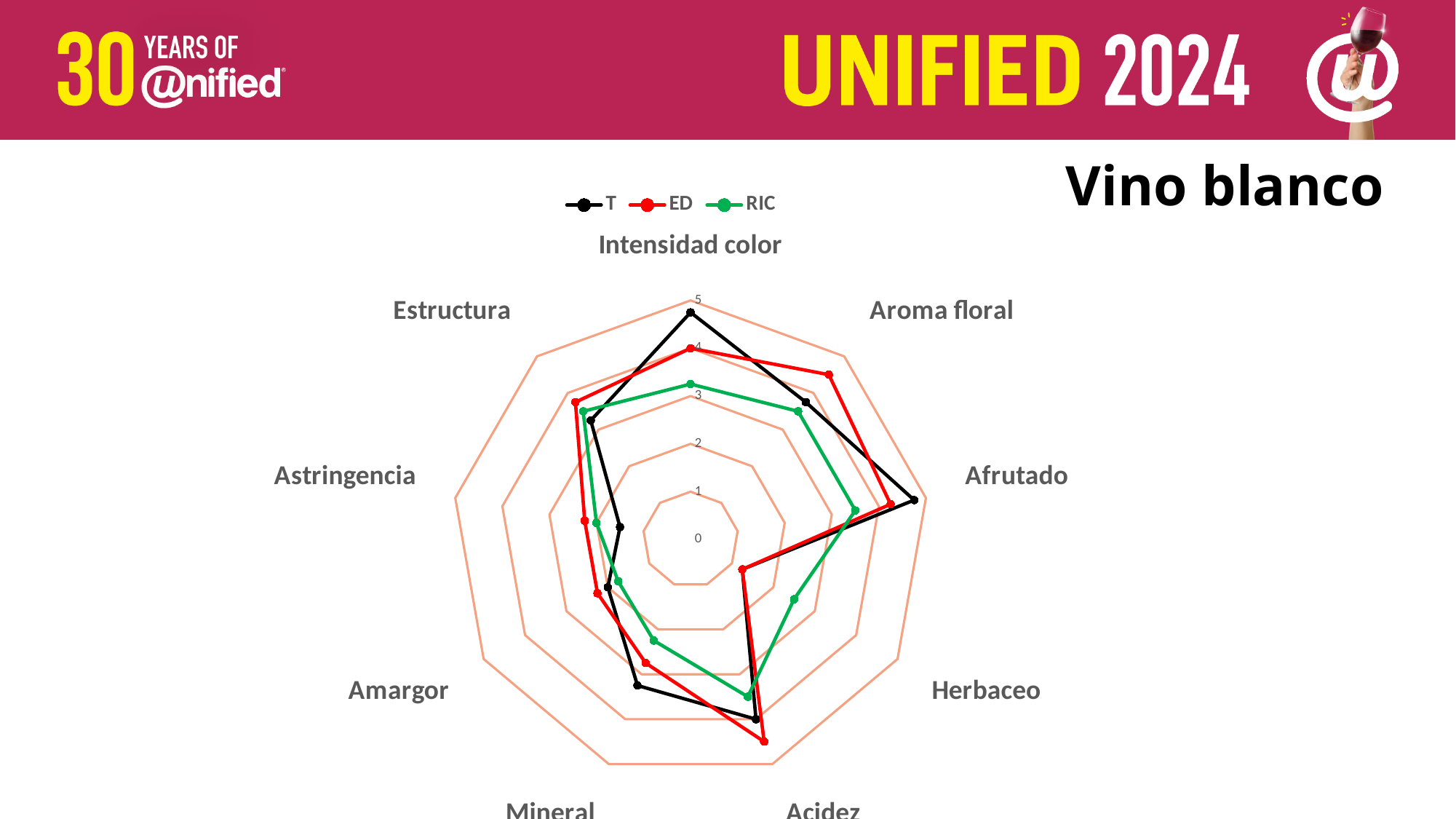
Is the value of RIC for Intensidad color greater or less than 4? less Is the value of T for Herbaceo greater or less than 2? less How many series does the legend list? 3 For Herbaceo, which series has the higher value, RIC or T? RIC Which series is drawn in red? ED Is the value of T for Intensidad color greater or less than 4? greater How many categories (axes) does the radar chart have? 9 What is the title shown next to the chart? Vino blanco For Intensidad color, which series has the higher value, T or RIC? T For the ED series, which category has the lowest value? Herbaceo What kind of chart is shown on the slide? Radar chart